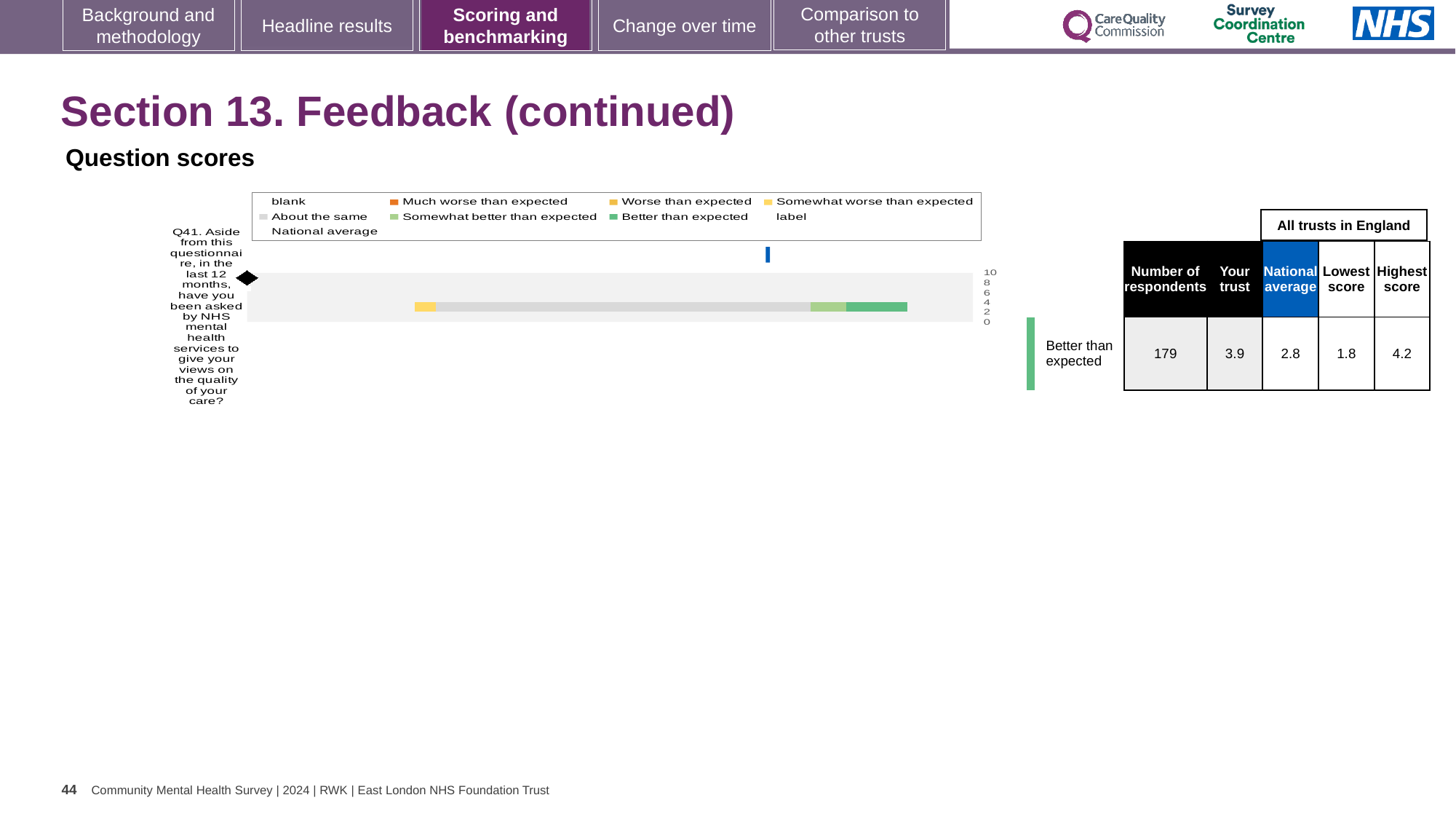
What is the difference between the highest and lowest scores among all trusts in England for Q41? 2.4 Which is higher for Q41, the 'Your trust' score or the national average? Your trust What is the 'Your trust' score for Q41? 3.9 How many respondents answered Q41? 179 What is the lowest score among all trusts in England for Q41? 1.8 What benchmark category is shown for Q41 next to the chart? Better than expected What is the highest score among all trusts in England for Q41? 4.2 How many questions (categories) are plotted in the chart? 1 What kind of chart is shown under 'Question scores'? bar chart What is the national average score for Q41? 2.8 What is the difference between the 'Your trust' score and the national average for Q41? 1.1 What colour does the legend use for 'Better than expected'? green